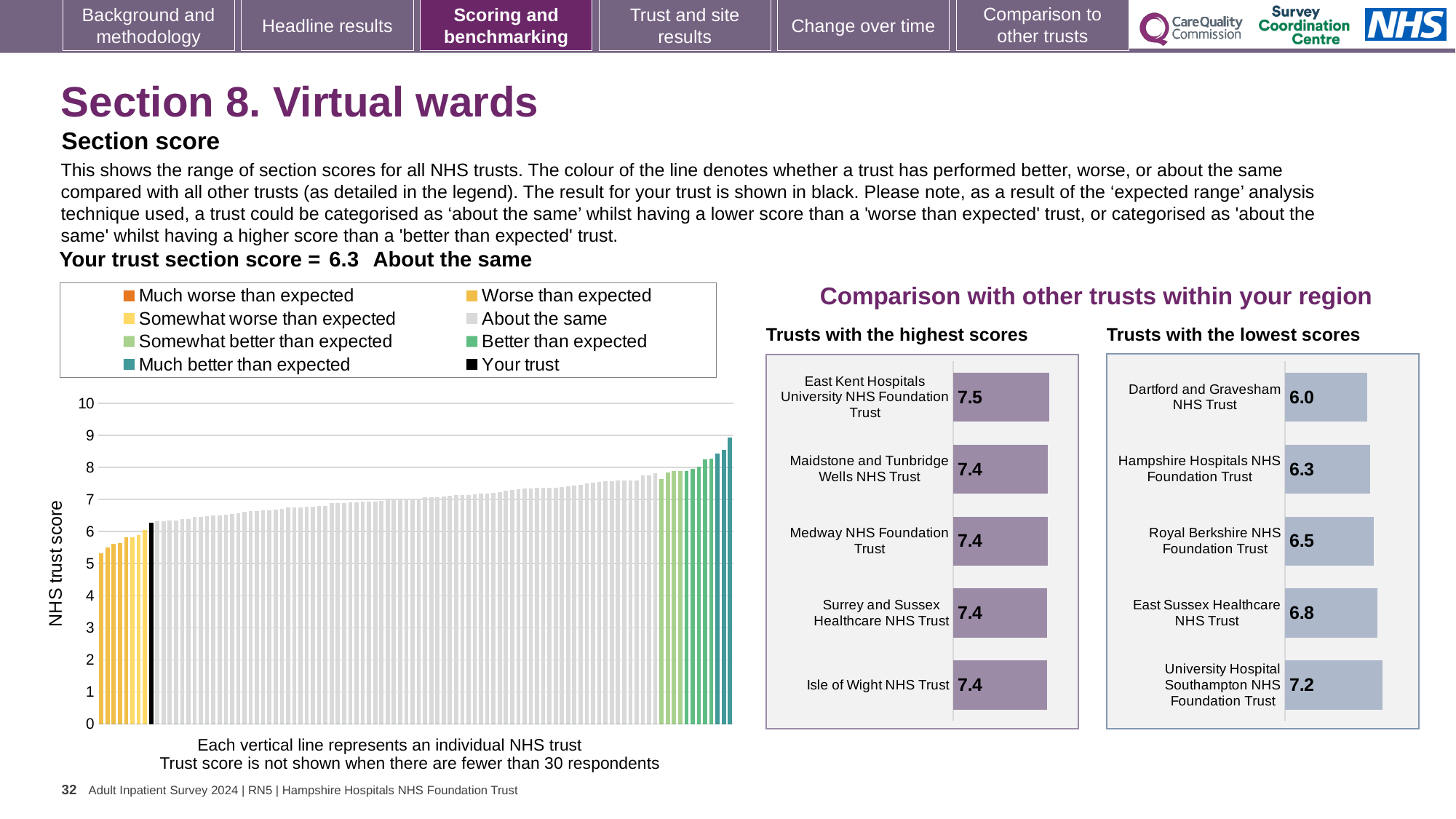
In the 'Trusts with the lowest scores' chart, which has the higher score: Royal Berkshire NHS Foundation Trust or East Sussex Healthcare NHS Trust? East Sussex Healthcare NHS Trust In the 'Trusts with the highest scores' chart, which trust has the highest score? East Kent Hospitals University NHS Foundation Trust How many entries does the legend above the large chart on the left list? 8 In the 'Trusts with the highest scores' chart, what is the difference between the scores of East Kent Hospitals University NHS Foundation Trust and Maidstone and Tunbridge Wells NHS Trust? 0.1 In the 'Trusts with the lowest scores' chart, what is the score for Dartford and Gravesham NHS Trust? 6.0 In the 'Trusts with the lowest scores' chart, which trust has the lowest score? Dartford and Gravesham NHS Trust What kind of chart is the large chart on the left showing NHS trust scores? bar chart In the large chart on the left showing NHS trust scores, do the values rise or fall from left to right? rise In the 'Trusts with the highest scores' chart, what is the score for East Kent Hospitals University NHS Foundation Trust? 7.5 In the 'Trusts with the lowest scores' chart, what is the score for Hampshire Hospitals NHS Foundation Trust? 6.3 In the 'Trusts with the lowest scores' chart, what is the difference between the scores of University Hospital Southampton NHS Foundation Trust and Dartford and Gravesham NHS Trust? 1.2 How many trusts are shown in the 'Trusts with the highest scores' chart? 5